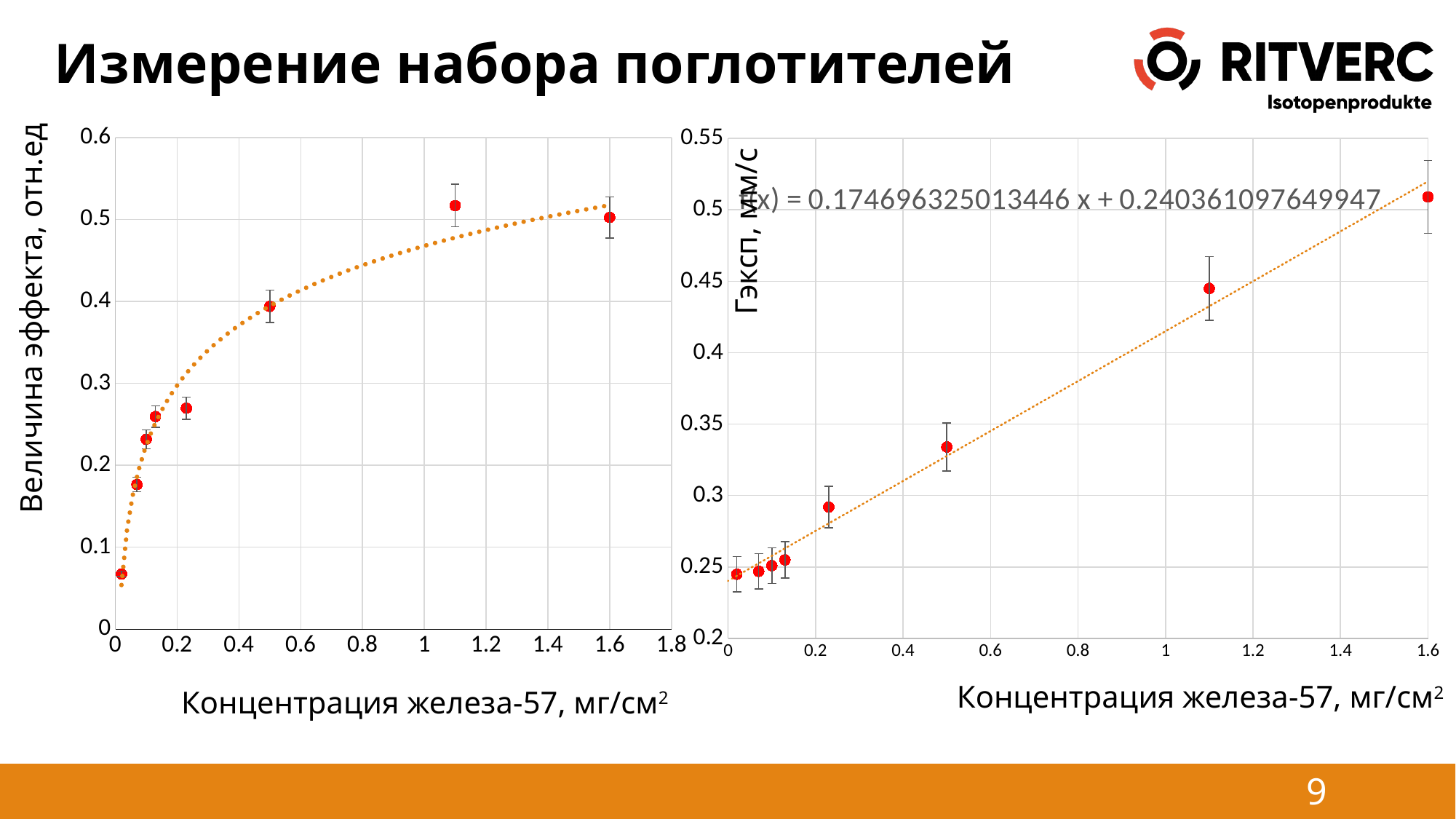
What is the slope of the trendline equation shown on the right chart (Гэксп, мм/с)? 0.174696325013446 On the right chart (Гэксп, мм/с), is the value at concentration 0.5 greater or less than 0.3? greater How many data points are plotted on the right chart (Гэксп, мм/с)? 8 On the right chart (Гэксп, мм/с), do the values rise or fall as the iron-57 concentration increases? rise On the right chart (Гэксп, мм/с), at which iron-57 concentration is the plotted value highest? 1.6 What kind of chart is the left chart (Величина эффекта vs. Концентрация железа-57)? scatter chart How many data points are plotted on the left chart (Величина эффекта, отн.ед)? 8 On the left chart (Величина эффекта, отн.ед), do the values rise or fall as the iron-57 concentration increases? rise On the left chart (Величина эффекта, отн.ед), is the value at concentration 0.5 greater or less than 0.3? greater On the left chart (Величина эффекта, отн.ед), is the value at concentration 0.23 greater or less than 0.3? less